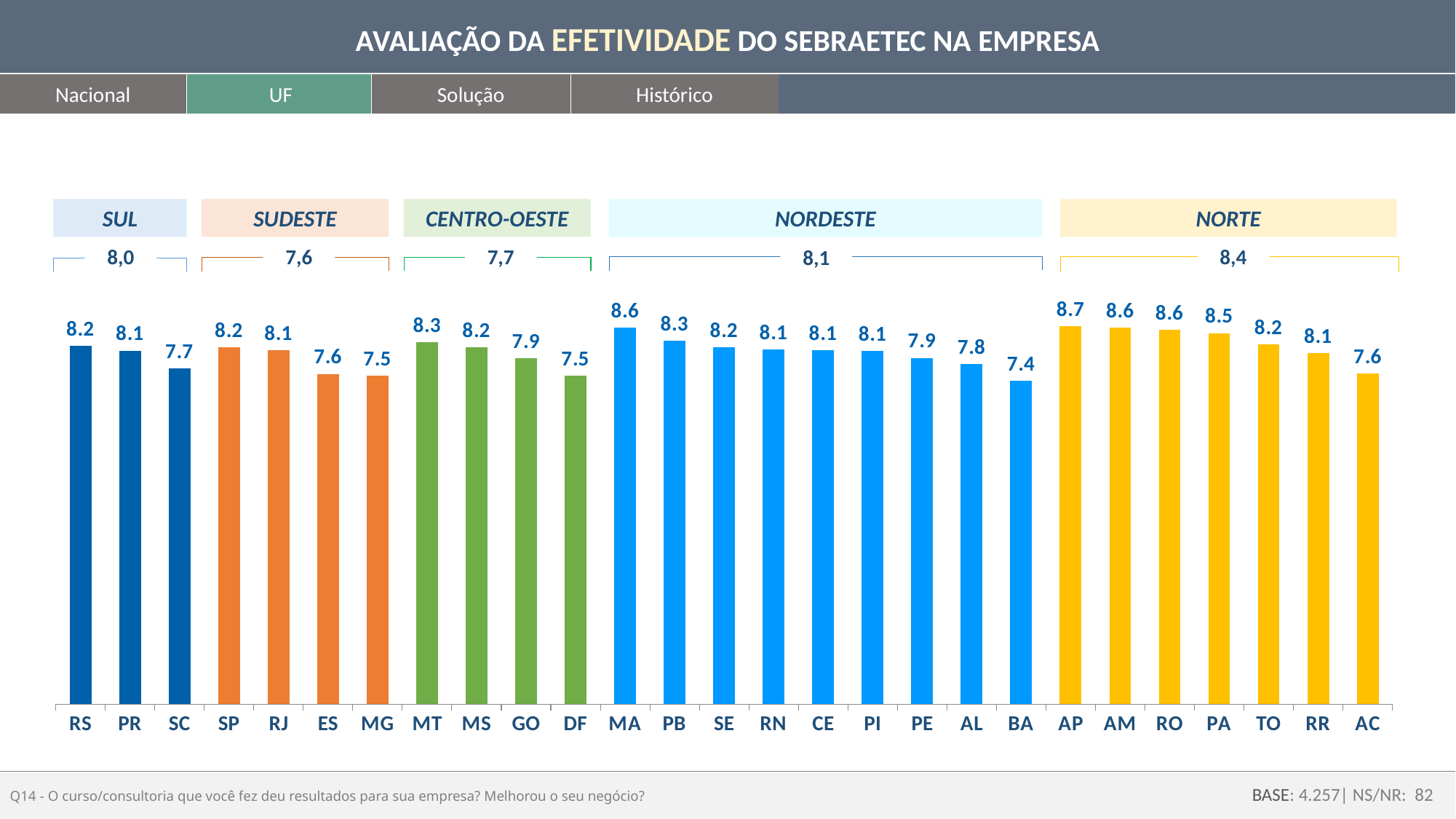
Within the NORDESTE group, do the values rise or fall from left to right? Fall What is the value for DF? 7.5 What is the value for MA? 8.6 What kind of chart is shown on the slide? Bar chart What is the difference between the values for AP and BA? 1.3 How many states (bars) are shown in the chart? 27 Which has a larger value, SC or ES? SC Which state has the lowest value? BA What is the difference between the values for MT and GO? 0.4 What is the value for PA? 8.5 What average value is shown for the NORTE region? 8,4 Which state has the highest value? AP